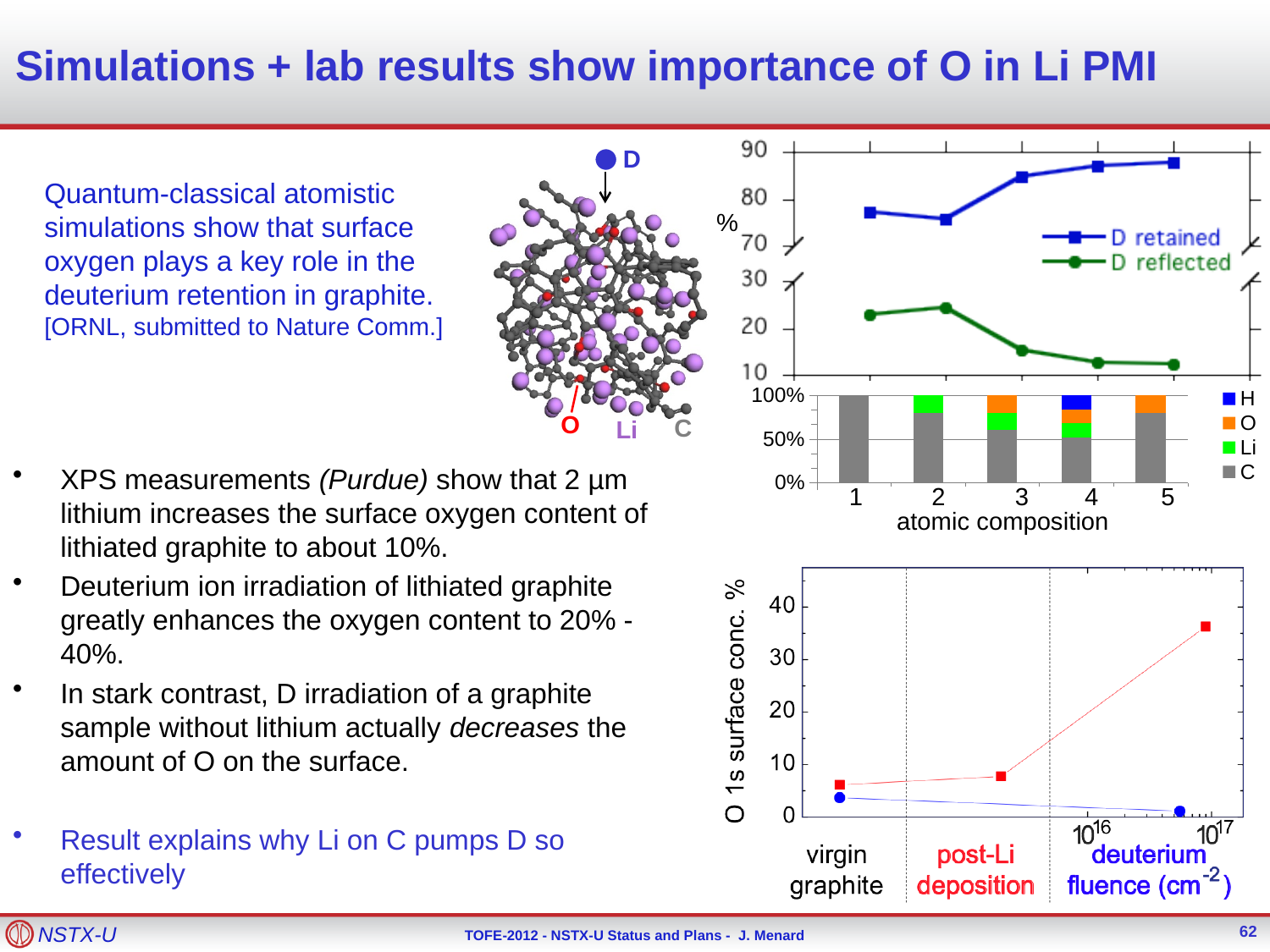
In the top-right line chart, which series has the larger value at atomic composition 3, 'D retained' or 'D reflected'? D retained In the stacked bar chart labelled 'atomic composition', how many bars are plotted? 5 In the bottom-right chart of O 1s surface concentration, which series has the larger value at the deuterium fluence stage, the red squares or the blue circles? red squares In the top-right line chart, is the 'D reflected' value at atomic composition 5 greater or less than 20? less In the stacked bar chart labelled 'atomic composition', which bar is the only one containing an H segment? 4 In the stacked bar chart labelled 'atomic composition', which bar has the smallest C share? 4 In the stacked bar chart labelled 'atomic composition', how many series does the legend list? 4 In the top-right line chart, is the 'D retained' value at atomic composition 1 greater or less than 70? greater In the bottom-right chart of O 1s surface concentration, is the red-square value at the deuterium fluence stage greater or less than 30? greater In the top-right line chart, how many series does the legend list? 2 In the top-right line chart, does the 'D reflected' series rise or fall as atomic composition goes from 1 to 5? fall In the top-right line chart, does the 'D retained' series rise or fall as atomic composition goes from 1 to 5? rise